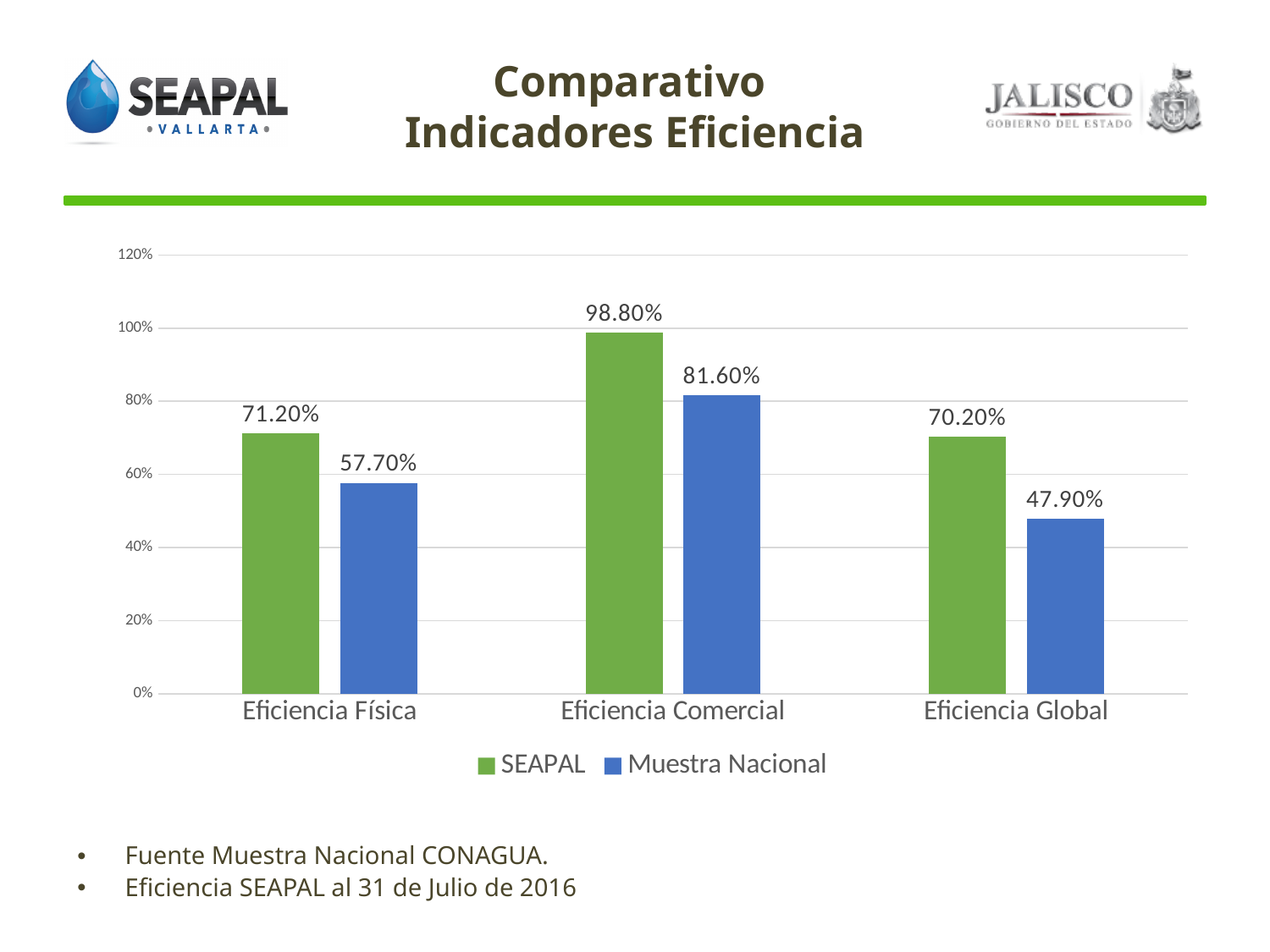
Which is larger: the SEAPAL value for Eficiencia Física or the Muestra Nacional value for Eficiencia Comercial? Muestra Nacional value for Eficiencia Comercial How many categories are shown on the x axis? 3 What kind of chart is shown on the slide? Bar chart How many series does the legend list? 2 What is the SEAPAL value for Eficiencia Comercial? 98.80% What is the difference between the SEAPAL and Muestra Nacional values for Eficiencia Global? 22.30% Which colour represents the SEAPAL series? Green Which category has the highest SEAPAL value? Eficiencia Comercial What is the Muestra Nacional value for Eficiencia Global? 47.90% What is the Muestra Nacional value for Eficiencia Física? 57.70% What is the difference between the SEAPAL and Muestra Nacional values for Eficiencia Física? 13.50% Which category has the lowest Muestra Nacional value? Eficiencia Global